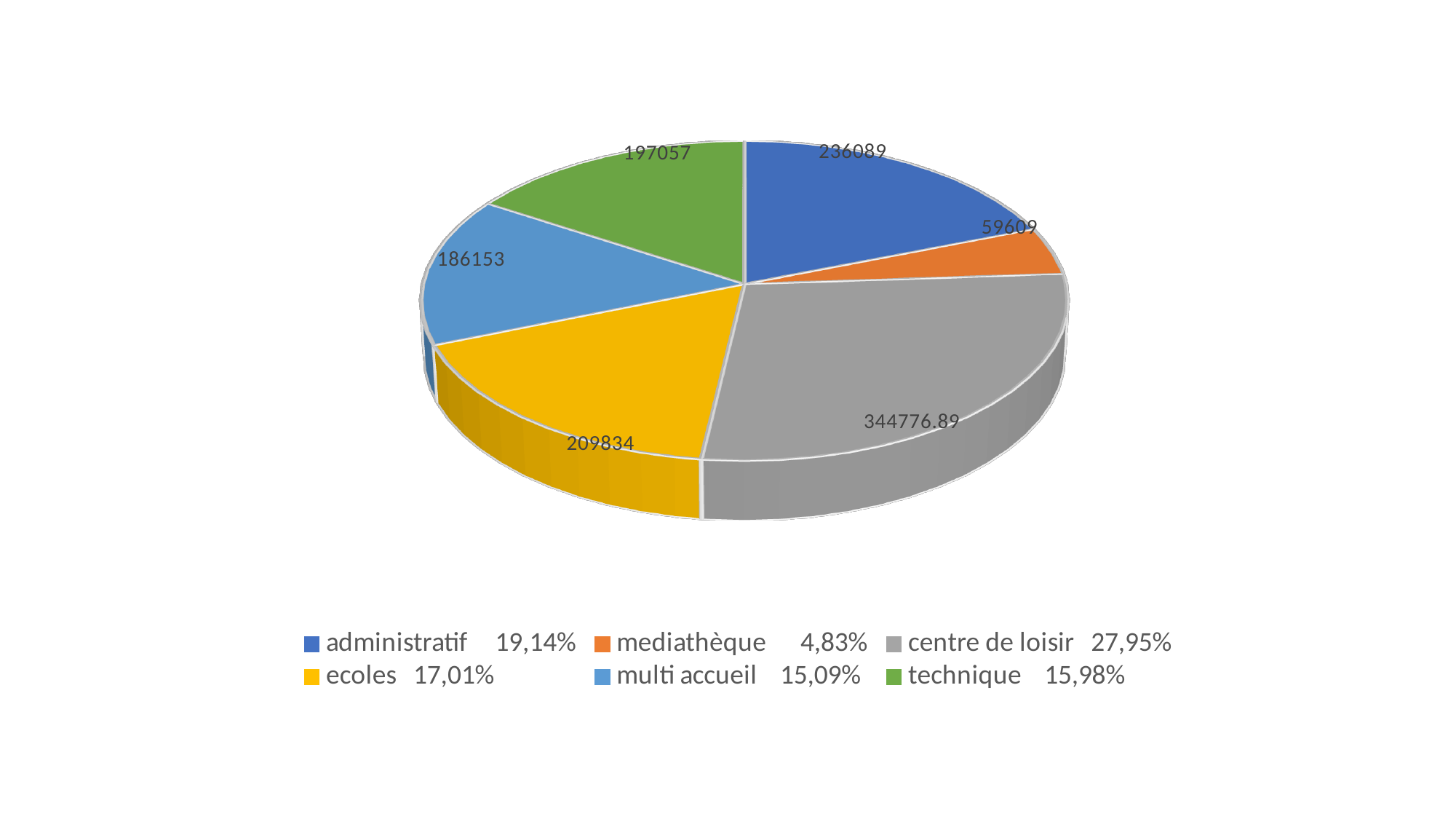
What is the value shown for the administratif slice? 236089 What is the value shown for the centre de loisir slice? 344776.89 Which category has the largest slice of the pie? centre de loisir What is the value shown for the multi accueil slice? 186153 Which is larger, the ecoles value or the multi accueil value? ecoles What is the difference between the administratif value and the technique value? 39032 What colour is the technique slice? green What is the value shown for the mediathèque slice? 59609 What share of the pie does the ecoles slice represent, according to the legend? 17,01% How many slices does the pie chart have? 6 What kind of chart is shown on the slide? pie chart Which category has the smallest slice of the pie? mediathèque